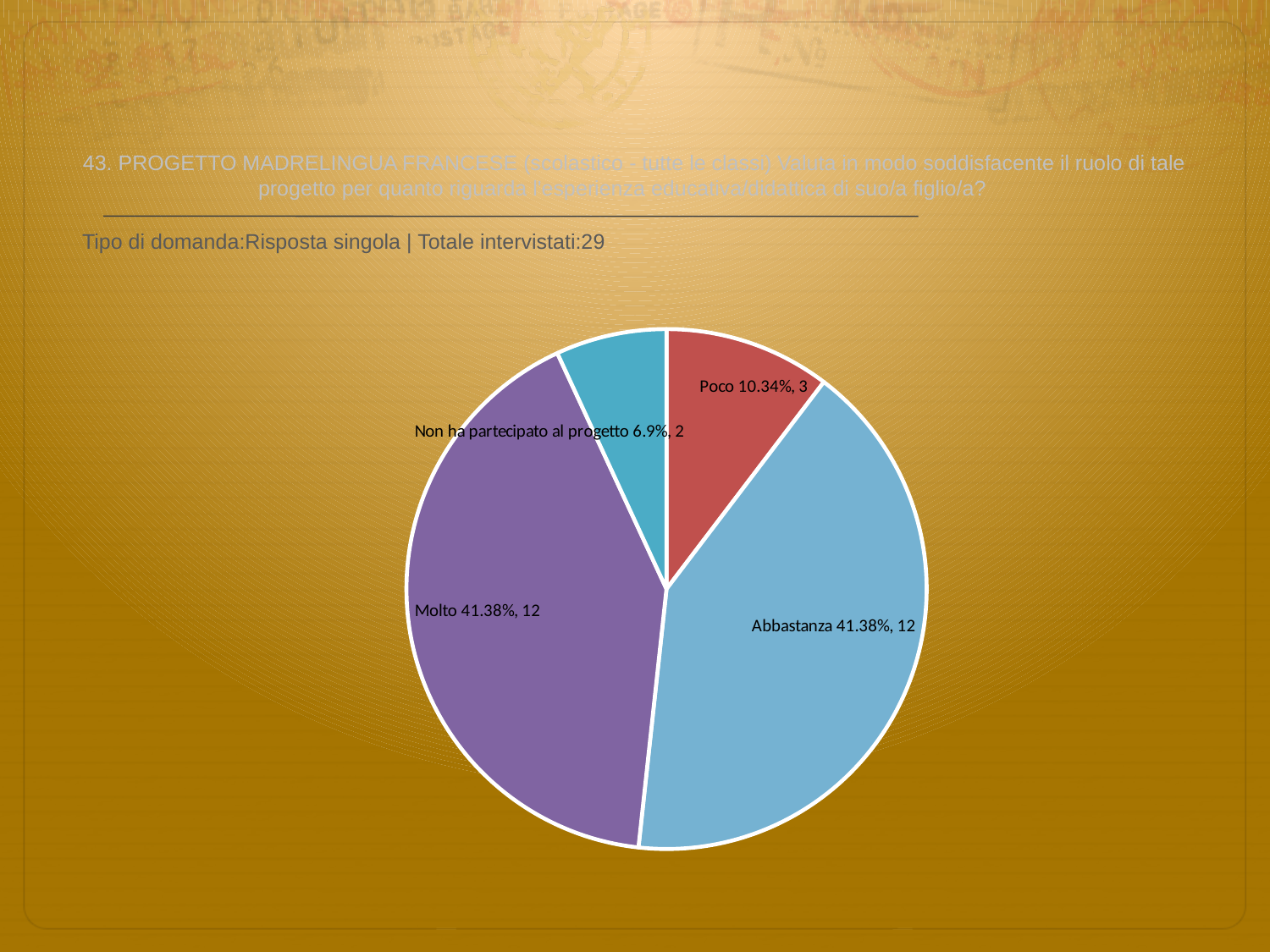
What kind of chart is shown on the slide? pie chart How many respondents answered Molto? 12 How many respondents answered Abbastanza? 12 Which is larger, the Poco slice or the Non ha partecipato al progetto slice? Poco Which category has the smallest slice of the pie? Non ha partecipato al progetto What percentage of the pie does the Poco slice represent? 10.34% How many respondents chose Non ha partecipato al progetto? 2 What is the difference in number of respondents between Abbastanza and Poco? 9 What is the total number of respondents across all slices of the pie? 29 What is the difference in number of respondents between Poco and Non ha partecipato al progetto? 1 What percentage of the pie does the Non ha partecipato al progetto slice represent? 6.9% How many slices does the pie chart have? 4